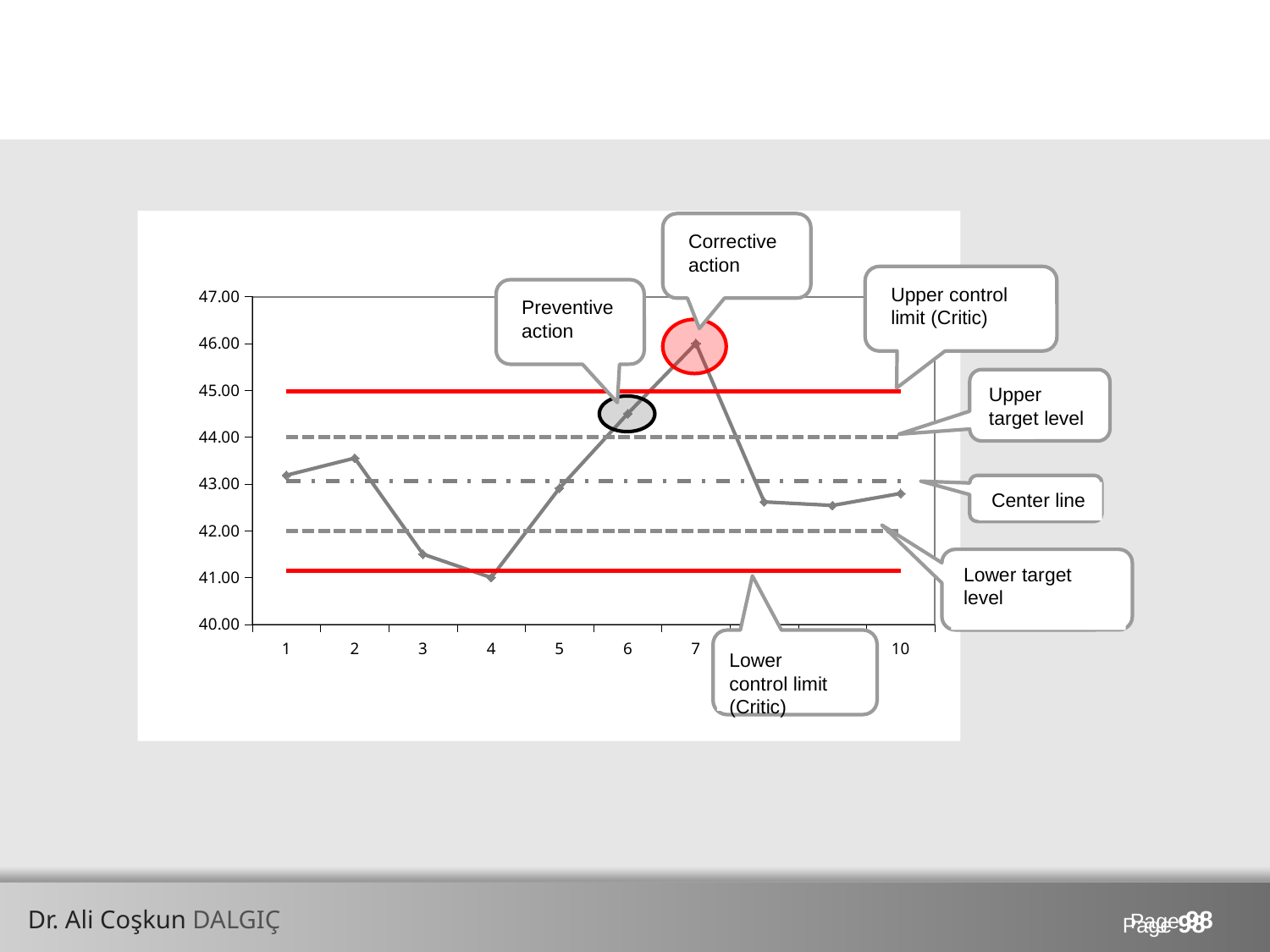
Is the value at point 6 greater or less than 44.00? greater Which point on the line is highlighted with the red circle labelled 'Corrective action'? 7 At which x-axis point does the plotted line reach its highest value? 7 Is the value at point 4 greater or less than 42.00? less Is the value at point 7 greater or less than 45.00? greater Which has the larger value, point 2 or point 3? point 2 Does the plotted line rise or fall from point 4 to point 7? rises What kind of chart is shown on the slide? line chart What does the solid red line at 45.00 represent, according to the callout? Upper control limit (Critic) Which has the larger value, point 6 or point 8? point 6 At which x-axis point does the plotted line reach its lowest value? 4